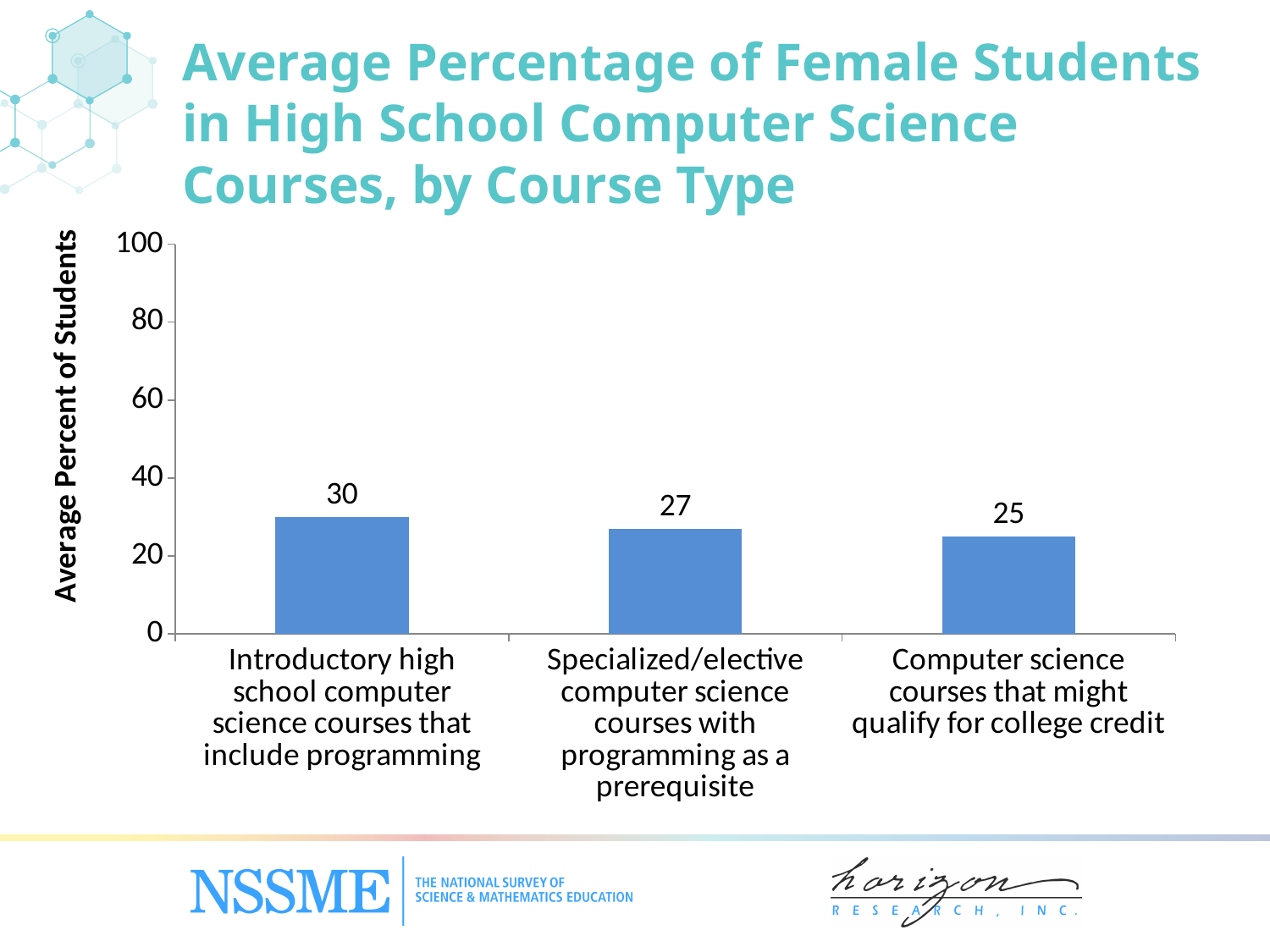
What is the average percent of female students in computer science courses that might qualify for college credit? 25 What kind of chart is shown on the slide? Bar chart Which course type has the highest average percent of female students? Introductory high school computer science courses that include programming What is the average percent of female students in introductory high school computer science courses that include programming? 30 What is the label of the vertical axis? Average Percent of Students What is the difference in average percent of female students between introductory courses that include programming and courses that might qualify for college credit? 5 What is the average percent of female students in specialized/elective computer science courses with programming as a prerequisite? 27 How many course types are shown in the chart? 3 Which course type has the lowest average percent of female students? Computer science courses that might qualify for college credit What is the difference in average percent of female students between specialized/elective courses with programming as a prerequisite and courses that might qualify for college credit? 2 Is the value for computer science courses that might qualify for college credit greater or less than 40? less Which has a higher average percent of female students: introductory courses that include programming or specialized/elective courses with programming as a prerequisite? Introductory high school computer science courses that include programming